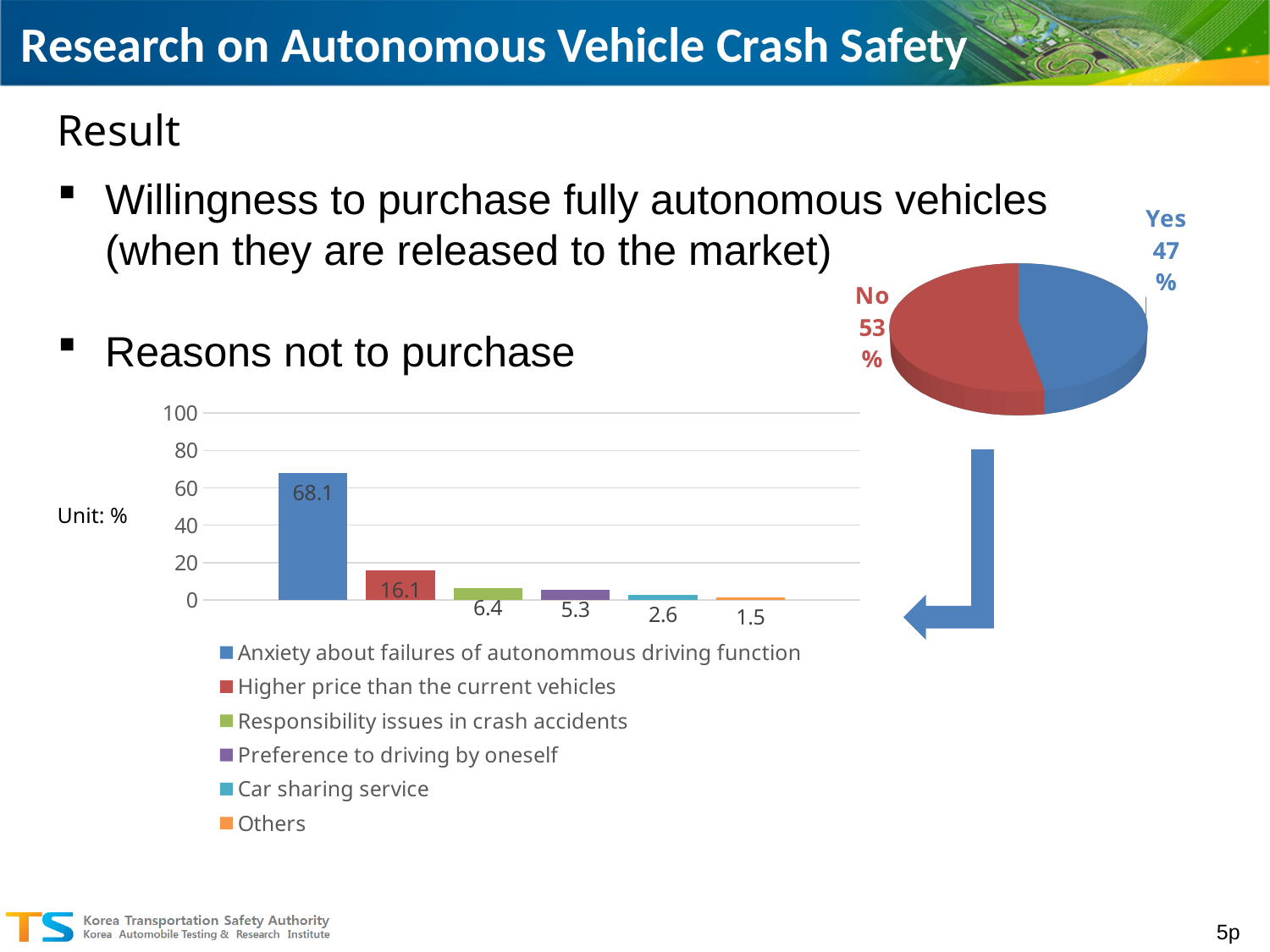
In the bar chart on reasons not to purchase, what is the value for 'Higher price than the current vehicles'? 16.1 In the bar chart on reasons not to purchase, which reason has the highest value? Anxiety about failures of autonommous driving function In the pie chart on the willingness to purchase fully autonomous vehicles, which answer has the larger share, Yes or No? No In the bar chart on reasons not to purchase, what is the difference between the values for 'Responsibility issues in crash accidents' and 'Preference to driving by oneself'? 1.1 In the bar chart on reasons not to purchase, how many reasons does the legend list? 6 What kind of chart is used to show the reasons not to purchase? Bar chart In the pie chart on the willingness to purchase fully autonomous vehicles, how many slices are there? 2 In the bar chart on reasons not to purchase, which reason has the lowest value? Others In the bar chart on reasons not to purchase, what is the value for 'Car sharing service'? 2.6 In the bar chart on reasons not to purchase, what is the value for 'Anxiety about failures of autonommous driving function'? 68.1 In the pie chart on the willingness to purchase fully autonomous vehicles, what share of respondents answered No? 53% In the pie chart on the willingness to purchase fully autonomous vehicles, what share of respondents answered Yes? 47%